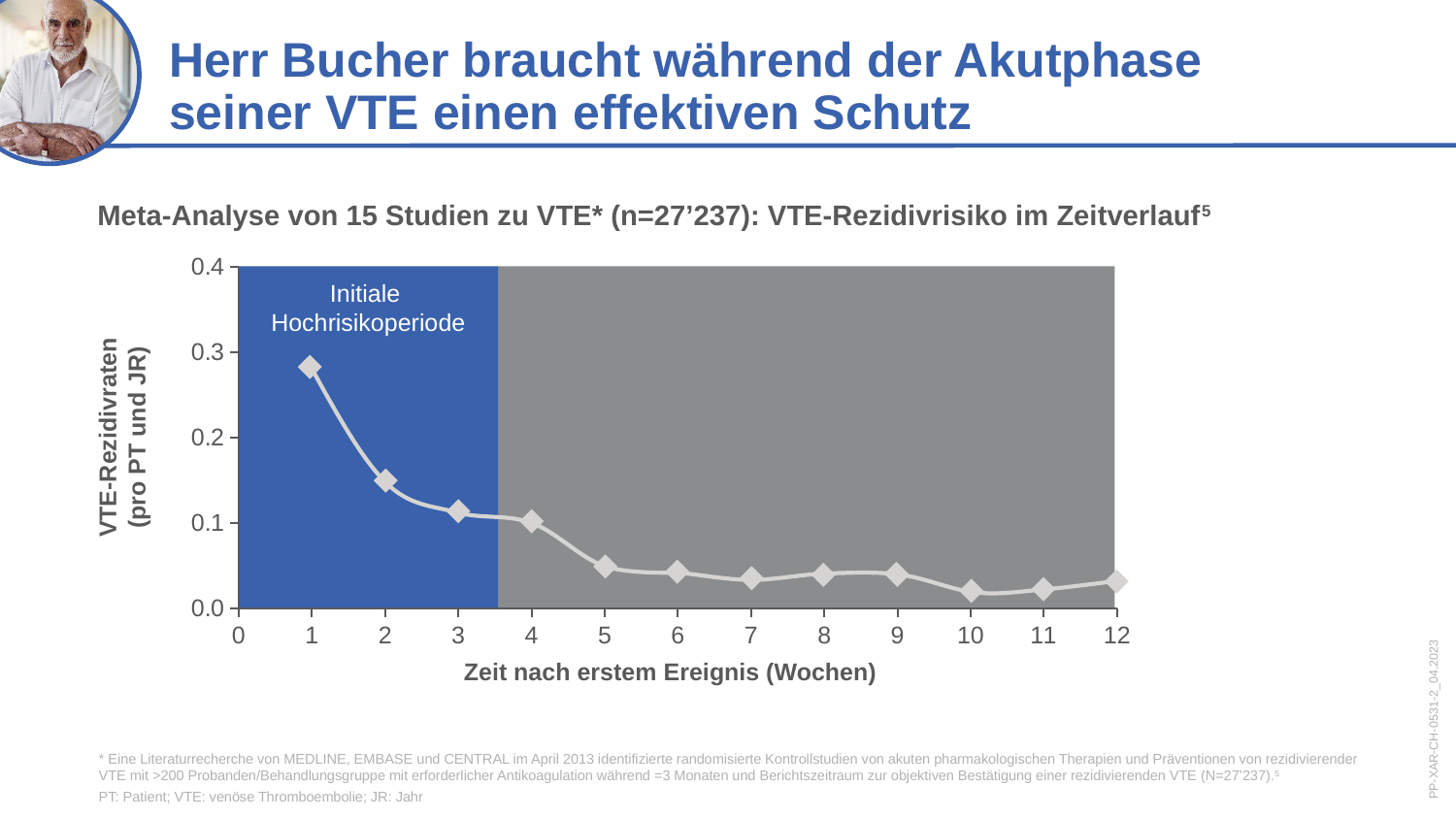
Does the VTE recurrence rate rise or fall as the weeks after the first event increase? Fall Which has the higher VTE recurrence rate, week 2 or week 10? Week 2 Which has the higher VTE recurrence rate, week 1 or week 5? Week 1 What is the label of the x axis? Zeit nach erstem Ereignis (Wochen) At which week after the first event is the VTE recurrence rate highest? 1 Is the VTE recurrence rate at week 12 greater or less than 0.1? less What label is shown in the blue shaded region of the chart? Initiale Hochrisikoperiode How many data points are plotted on the line? 12 Is the VTE recurrence rate at week 2 greater or less than 0.1? greater Is the VTE recurrence rate at week 5 greater or less than 0.1? less What kind of chart is shown on the slide? Line chart